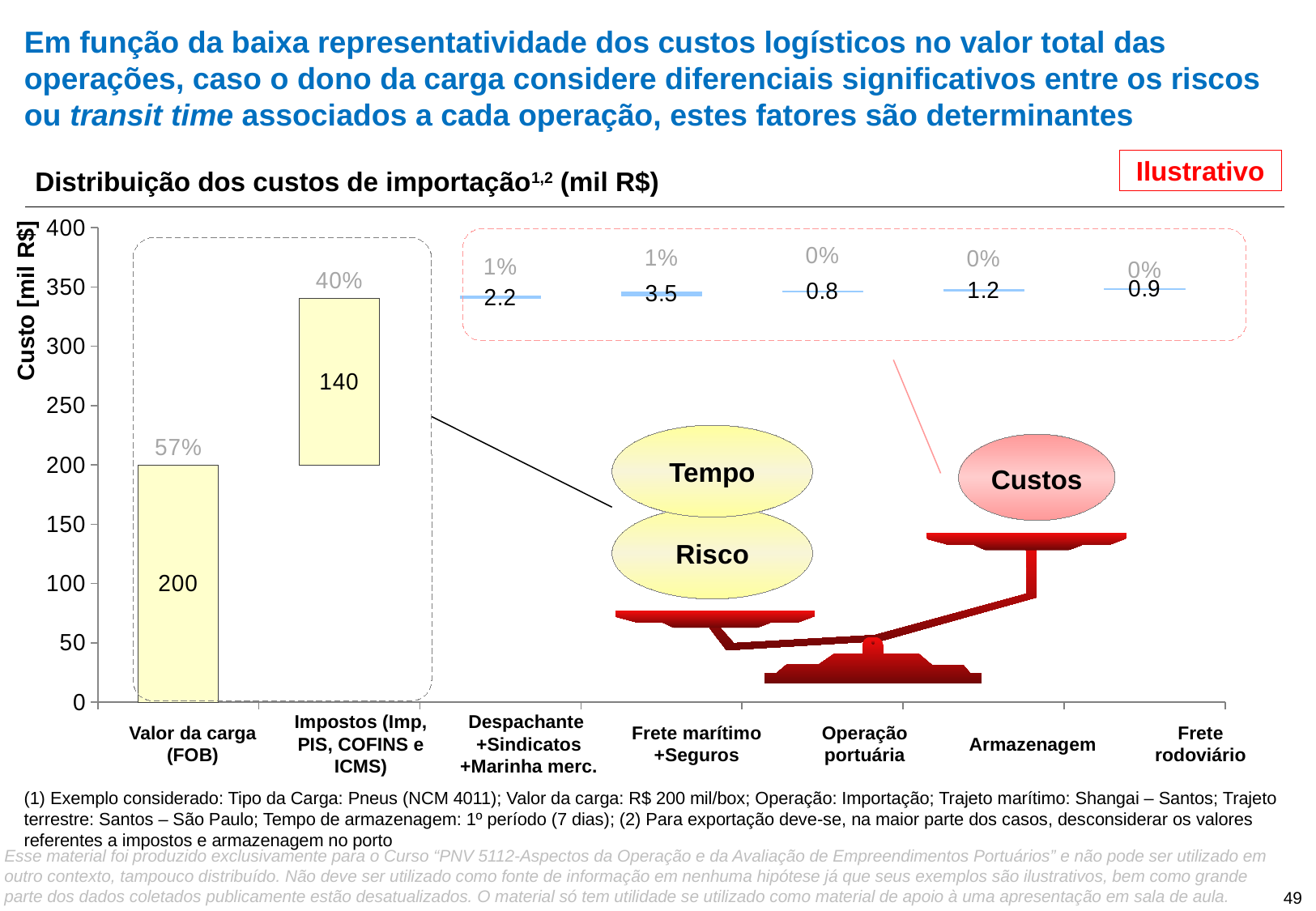
What percentage share is shown above the Valor da carga (FOB) bar? 57% What is the value for Despachante +Sindicatos +Marinha merc.? 2.2 What is the value for Valor da carga (FOB) in the chart? 200 What is the value for Operação portuária? 0.8 What is the value for Impostos (Imp, PIS, COFINS e ICMS)? 140 Which category has the highest value in the chart? Valor da carga (FOB) How many categories are shown on the x axis of the chart? 7 What is the title of the chart? Distribuição dos custos de importação (mil R$) Which category has the lowest value in the chart? Operação portuária Which is larger, the value for Armazenagem or the value for Frete rodoviário? Armazenagem What is the value for Frete marítimo +Seguros? 3.5 What is the difference between the values for Valor da carga (FOB) and Impostos (Imp, PIS, COFINS e ICMS)? 60